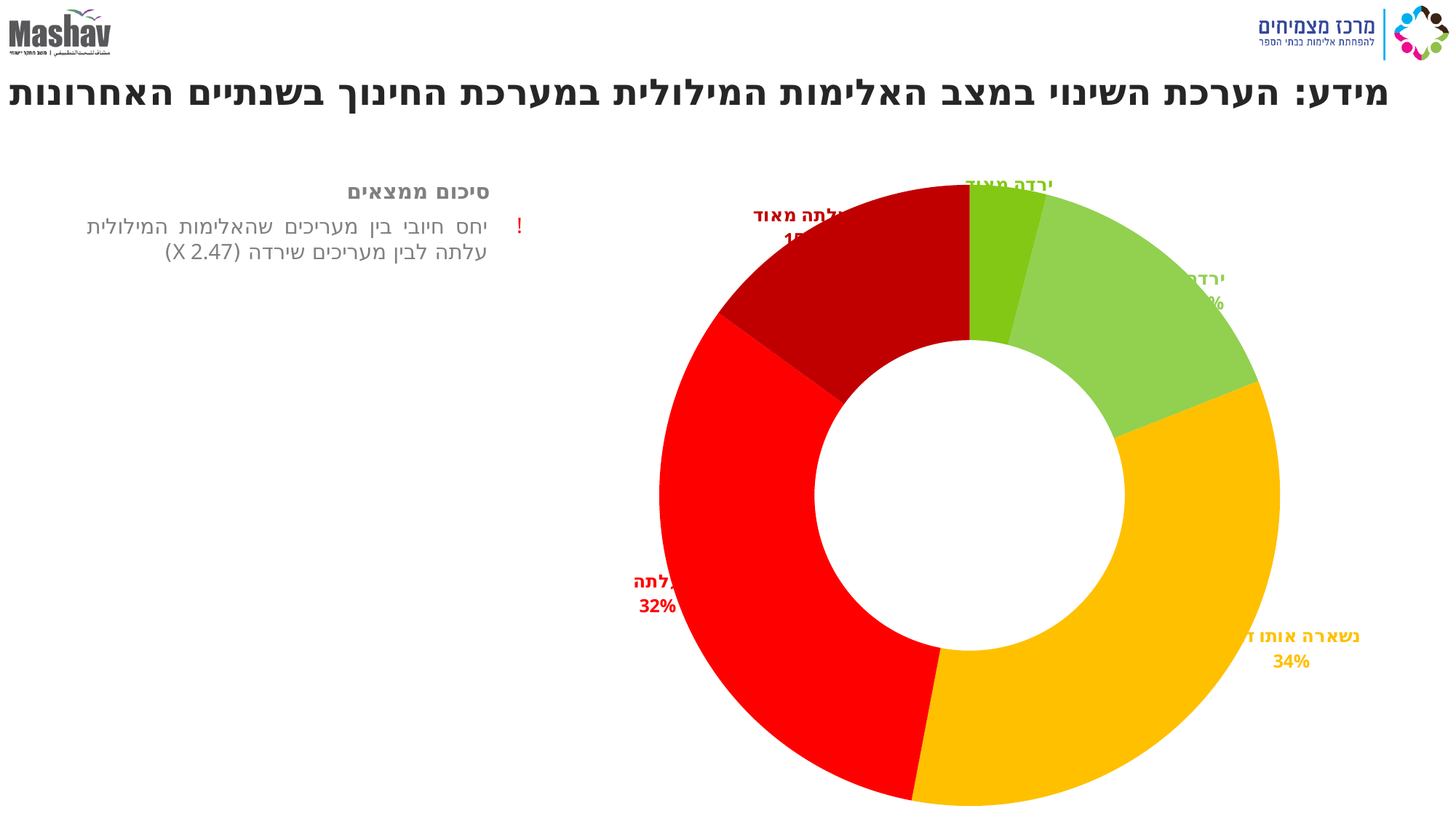
What is the difference in percentage points between the נשארה אותו דבר slice and the עלתה slice? 2 percentage points Which slice of the donut chart is the smallest? ירדה מאוד What colour is the slice labelled נשארה אותו דבר? Yellow How many slices does the donut chart have? 5 What colour is the slice labelled עלתה? Red What percentage is shown for the slice labelled נשארה אותו דבר? 34% What percentage is shown for the slice labelled עלתה? 32% Which is larger: the share for נשארה אותו דבר or the share for עלתה? נשארה אותו דבר What kind of chart is shown on the slide? Donut (pie) chart Which slice of the donut chart is the largest? נשארה אותו דבר